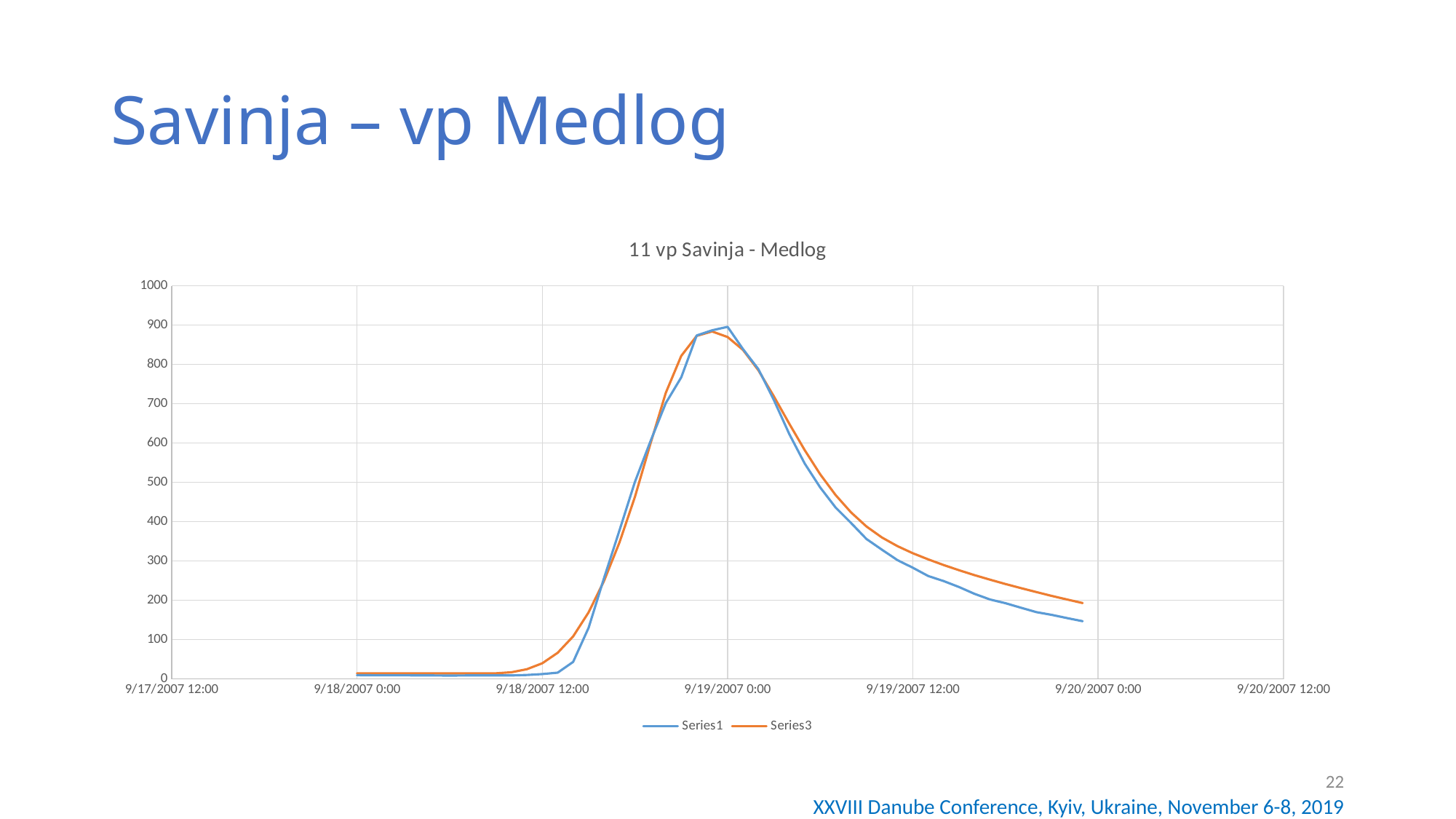
Is the value of Series3 at 9/18/2007 12:00 greater or less than 300? less At 9/18/2007 12:00, which series has the higher value, Series1 or Series3? Series3 Which colour is used for Series3 in the chart? orange How many series does the legend list? 2 Is the value of Series1 at 9/19/2007 0:00 greater or less than 800? greater Do the values of Series1 rise or fall between 9/19/2007 0:00 and 9/20/2007 0:00? fall At 9/19/2007 12:00, which series has the higher value, Series1 or Series3? Series3 What is the title of the chart? 11 vp Savinja - Medlog Do the values of Series3 rise or fall between 9/18/2007 12:00 and 9/19/2007 0:00? rise What kind of chart is shown on the slide? line chart Is the value of Series1 at 9/18/2007 0:00 greater or less than 100? less